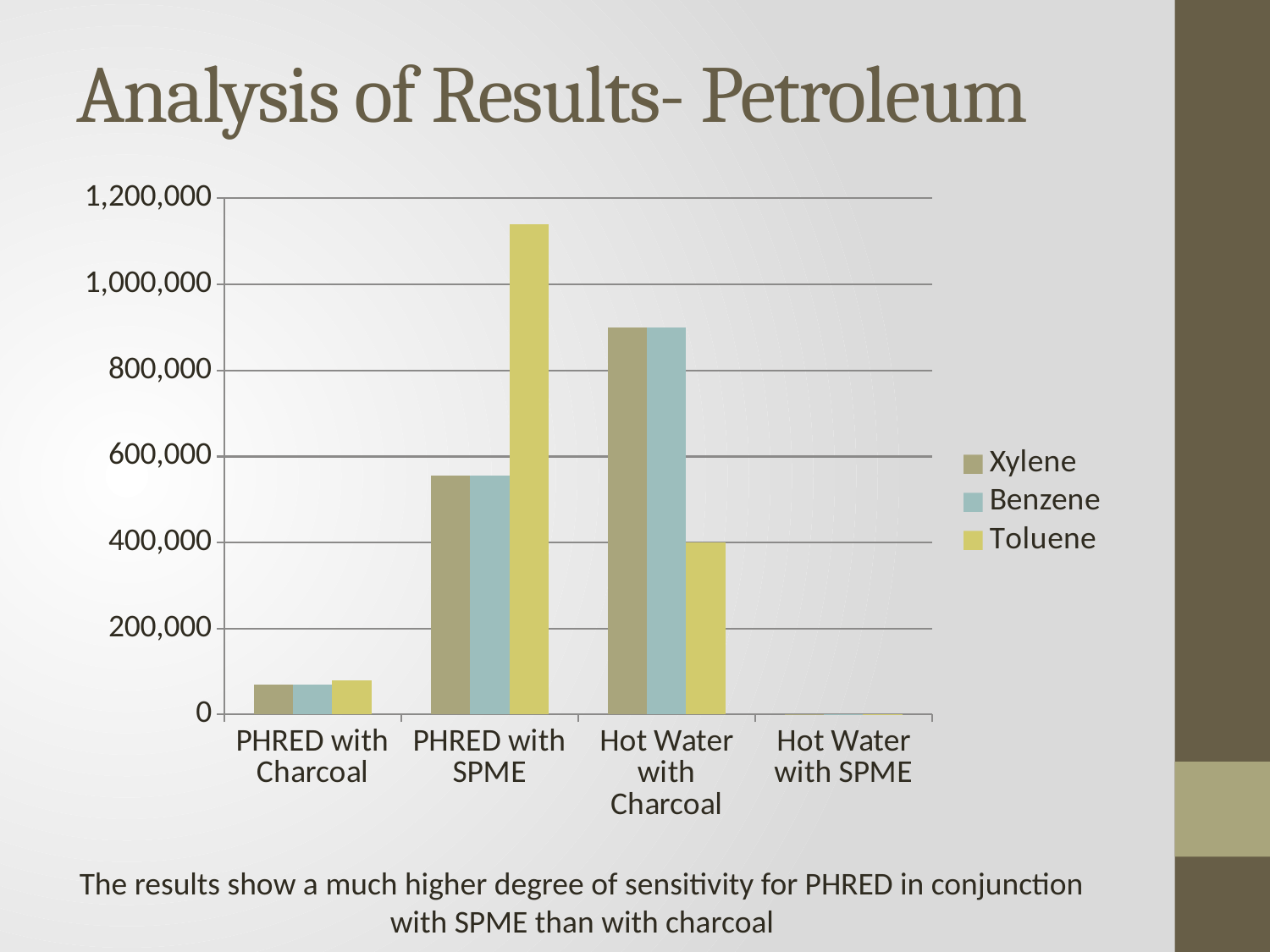
Which category has the highest Toluene value? PHRED with SPME Which category has the lowest Benzene value? Hot Water with SPME How many series does the legend list? 3 Which is larger for Hot Water with Charcoal, the Xylene value or the Toluene value? Xylene What are the three series listed in the legend? Xylene, Benzene, Toluene Is the Xylene value for PHRED with Charcoal greater or less than 200,000? less What kind of chart is shown on the slide? bar chart Which is larger for PHRED with SPME, the Benzene value or the Toluene value? Toluene How many categories are shown on the x axis? 4 Is the Toluene value for PHRED with SPME greater or less than 1,000,000? greater Which category has the highest Xylene value? Hot Water with Charcoal Is the Benzene value for Hot Water with Charcoal greater or less than 800,000? greater